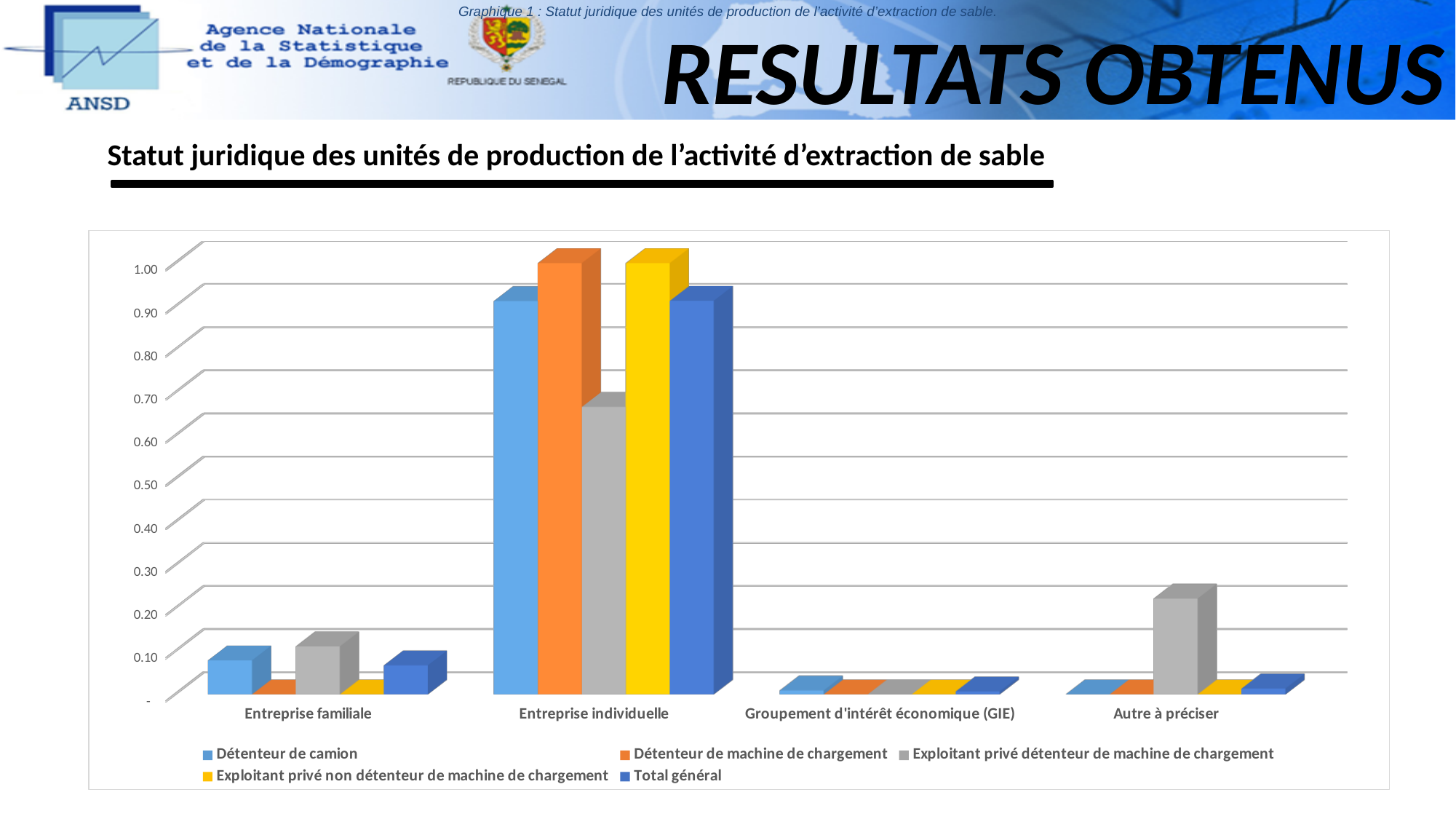
In the category Entreprise individuelle, which series has the lowest value? Exploitant privé détenteur de machine de chargement How many categories are shown on the x axis of the chart? 4 In the category Entreprise individuelle, which is larger: the value for Détenteur de camion or the value for Exploitant privé détenteur de machine de chargement? Détenteur de camion Which category has the highest value for the series Détenteur de camion? Entreprise individuelle What kind of chart is shown on the slide? bar chart How many series does the chart legend list? 5 Is the value for Exploitant privé détenteur de machine de chargement in the category Autre à préciser greater or less than 0.30? less What colour represents the series Total général in the chart legend? dark blue Is the value for Détenteur de camion in the category Entreprise individuelle greater or less than 0.80? greater Is the value for Total général in the category Entreprise familiale greater or less than 0.10? less What is the title of the chart shown on the slide? Statut juridique des unités de production de l'activité d'extraction de sable